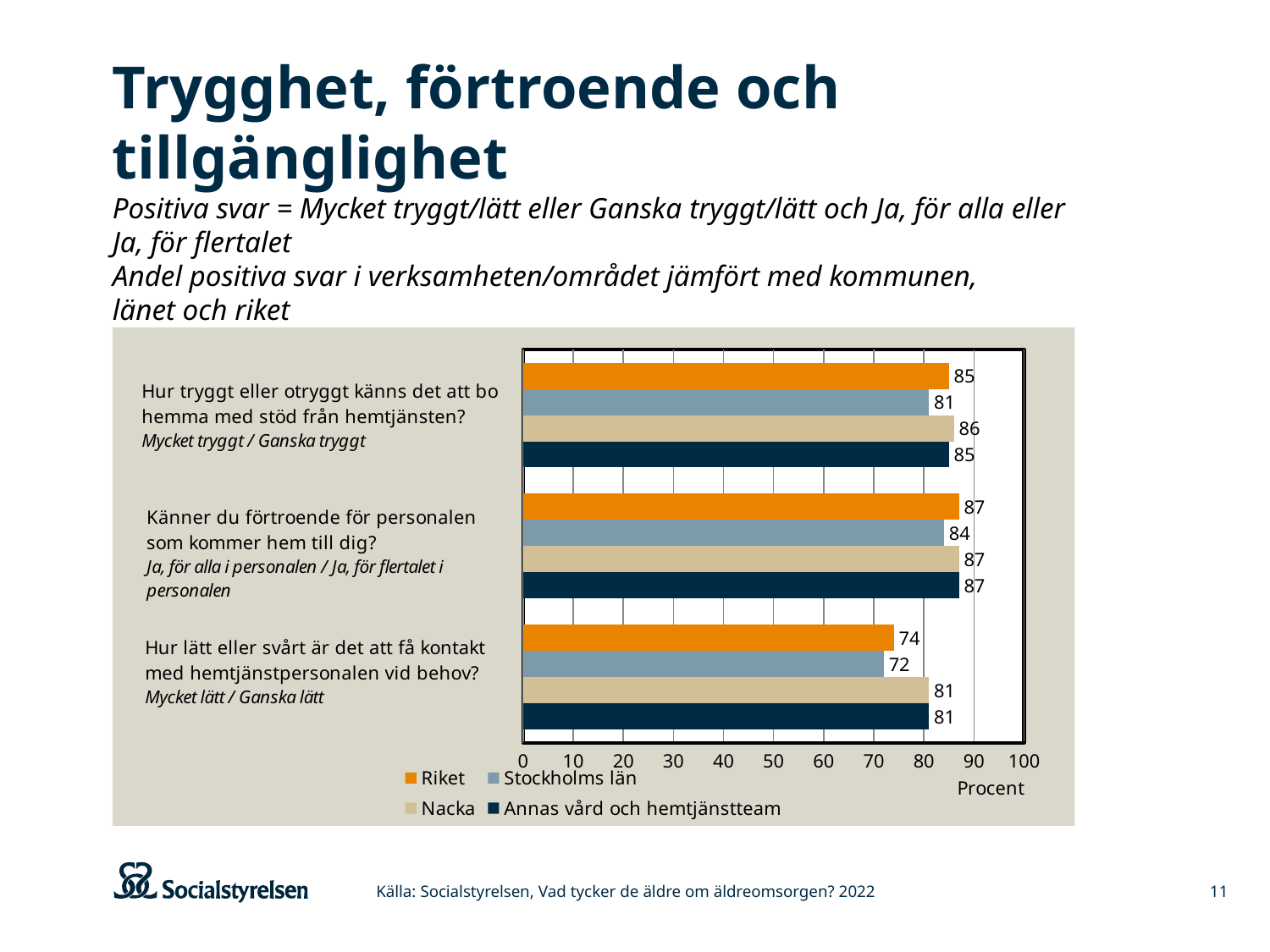
What is the value for Stockholms län on the question "Känner du förtroende för personalen som kommer hem till dig?" 84 What is the difference between Nacka and Stockholms län on the question "Hur lätt eller svårt är det att få kontakt med hemtjänstpersonalen vid behov?" 9 Which series has the highest value on the question "Hur tryggt eller otryggt känns det att bo hemma med stöd från hemtjänsten?" Nacka What is the difference between Riket and Stockholms län on the question "Hur tryggt eller otryggt känns det att bo hemma med stöd från hemtjänsten?" 4 What is the value for Riket on the question "Hur tryggt eller otryggt känns det att bo hemma med stöd från hemtjänsten?" 85 How many questions (categories) are shown on the chart? 3 What is the value for Nacka on the question "Hur lätt eller svårt är det att få kontakt med hemtjänstpersonalen vid behov?" 81 Which series has the lowest value on the question "Hur lätt eller svårt är det att få kontakt med hemtjänstpersonalen vid behov?" Stockholms län What kind of chart is shown on the slide? Bar chart What is the value for Annas vård och hemtjänstteam on the question "Hur lätt eller svårt är det att få kontakt med hemtjänstpersonalen vid behov?" 81 How many series does the legend list? 4 Which is larger on the question "Hur lätt eller svårt är det att få kontakt med hemtjänstpersonalen vid behov?": Riket or Nacka? Nacka